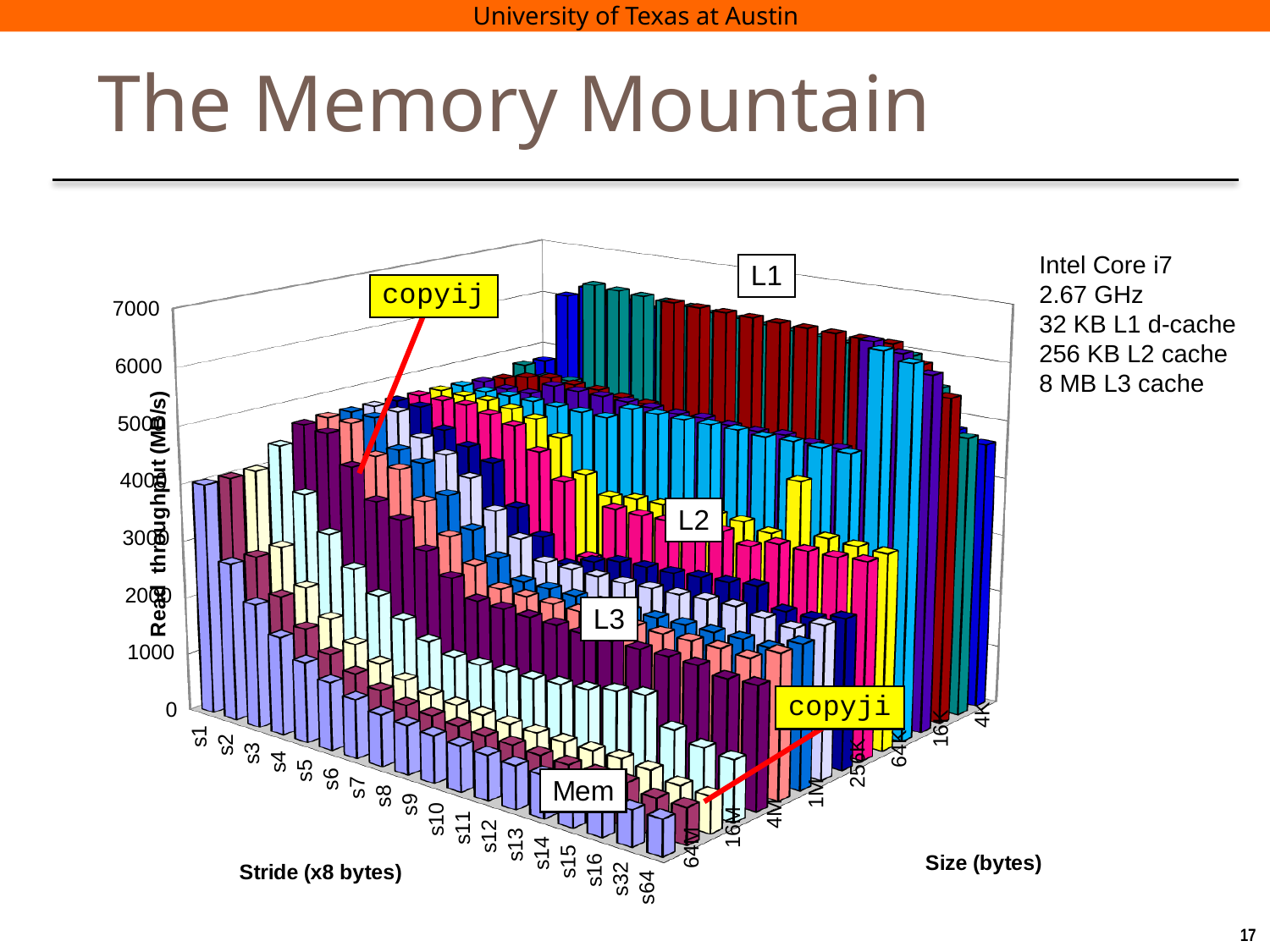
How many stride categories are shown along the Stride (x8 bytes) axis? 18 Which labelled region of the chart has the highest read throughput: L1, L2, L3 or Mem? L1 Are the bars in the region labelled Mem at stride s64 greater or less than 1000 MB/s? less Which labelled region of the chart has the lowest read throughput: L1, L2, L3 or Mem? Mem How many size categories are shown along the Size (bytes) axis? 16 What is the highest tick value shown on the Read throughput (MB/s) axis? 7000 Is the tallest bar in the region labelled L1 greater or less than 6000 MB/s? greater Moving from size 4K toward size 64M at a fixed stride, does read throughput generally rise or fall? fall Is the read throughput in the L1 region larger or smaller than in the L3 region? larger What is the label of the vertical axis of the chart? Read throughput (MB/s) What kind of chart is shown on the slide? bar chart